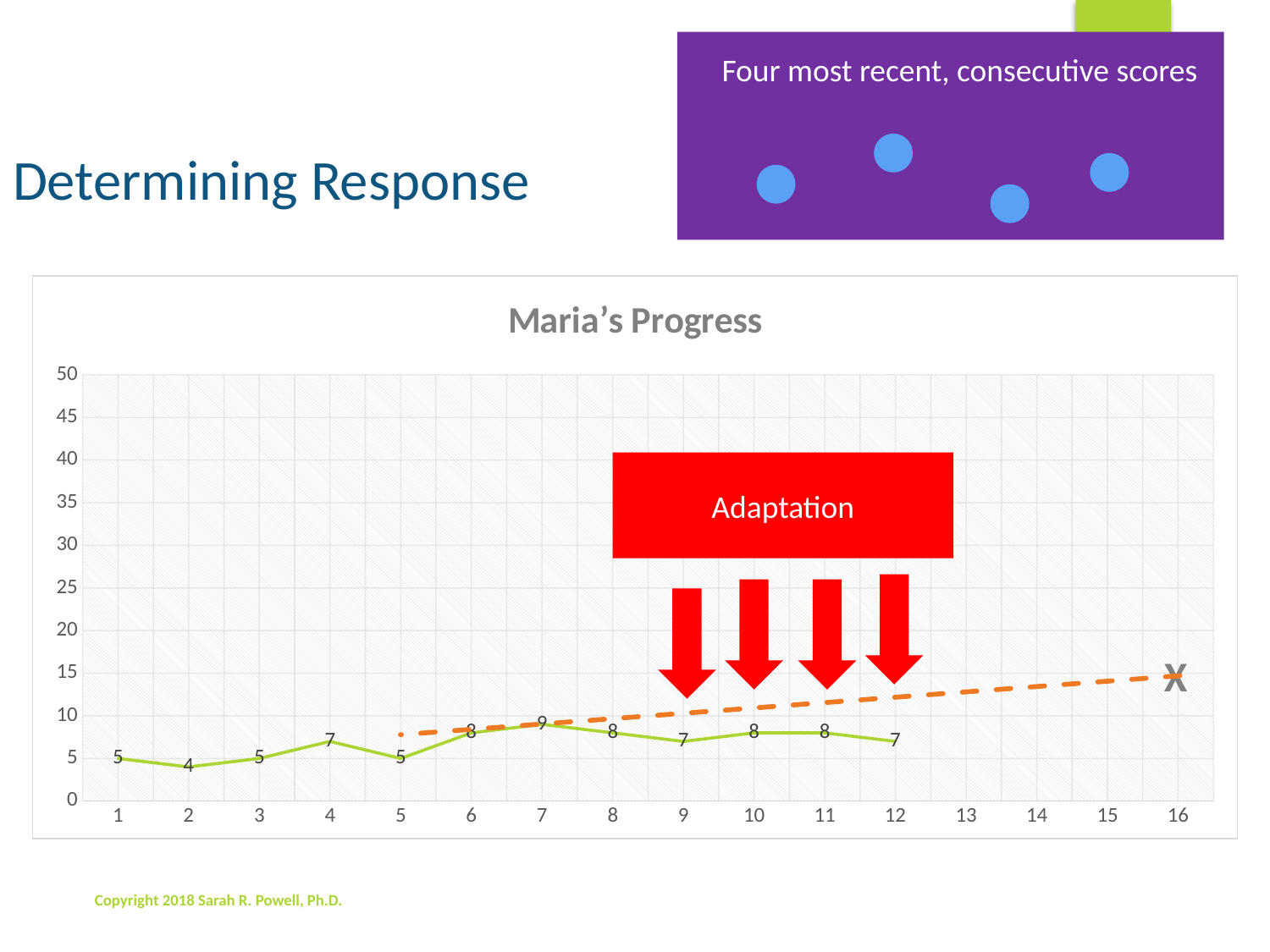
Which is larger, Maria's score at point 4 or at point 5? point 4 What kind of chart is shown on the slide? line chart Is Maria's score at point 10 greater or less than 10? less At which point is Maria's score highest? 7 At which point is Maria's score lowest? 2 What is Maria's score at point 2? 4 What is the highest value shown on the y axis? 50 What is Maria's score at point 12? 7 What is the title of the chart? Maria's Progress How many data points are plotted on the green line? 12 What is the difference between Maria's score at point 7 and her score at point 1? 4 What is Maria's score at point 7? 9